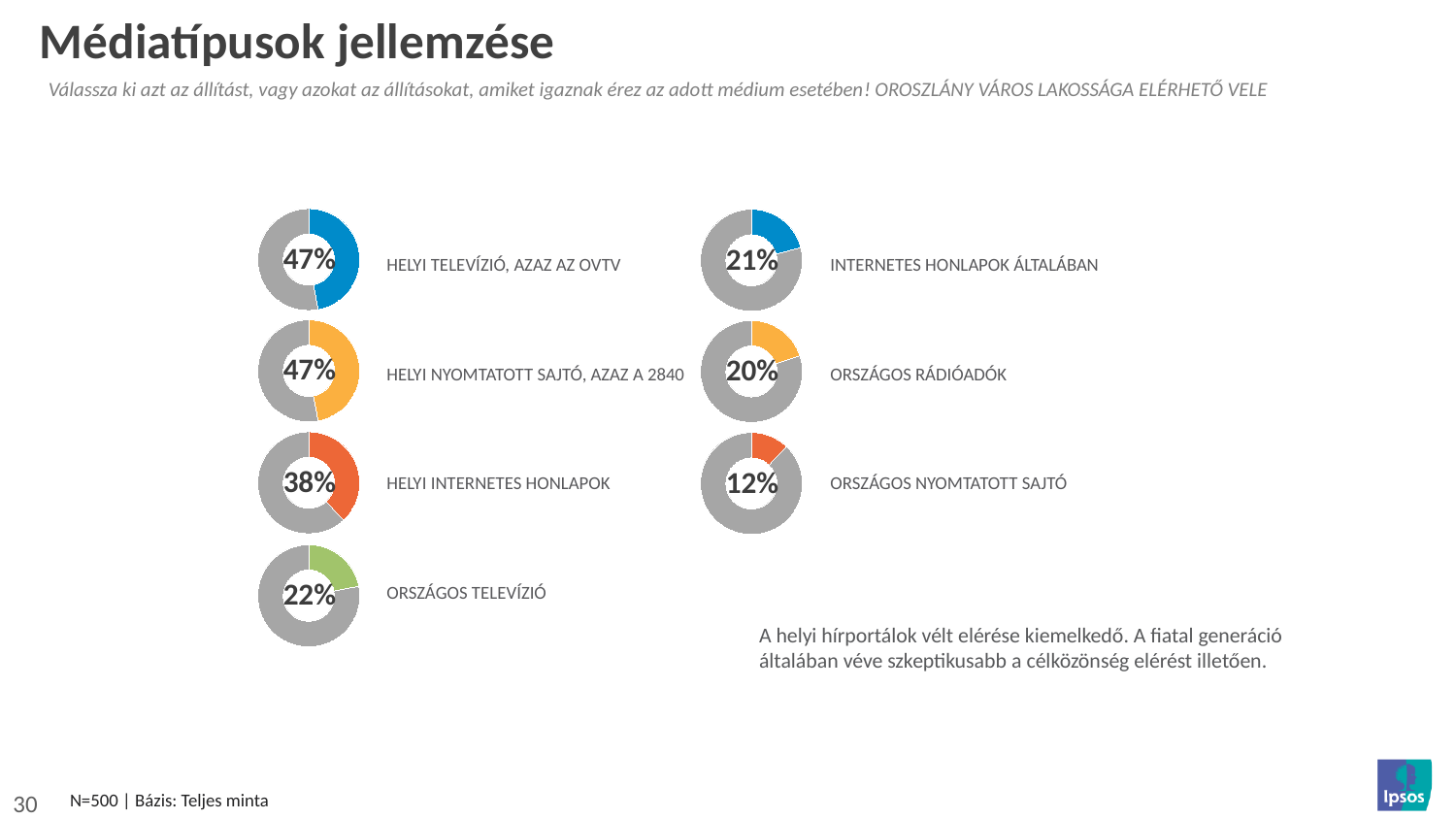
What is the difference between the percentage for HELYI INTERNETES HONLAPOK and the percentage for ORSZÁGOS NYOMTATOTT SAJTÓ? 26% What kind of chart is used to show the percentage for each medium on the slide? Donut chart What percentage is shown in the donut chart for ORSZÁGOS NYOMTATOTT SAJTÓ? 12% How many donut charts are shown on the slide? 7 What percentage is shown in the donut chart for ORSZÁGOS TELEVÍZIÓ? 22% What percentage is shown in the donut chart for ORSZÁGOS RÁDIÓADÓK? 20% Which is larger: the percentage for HELYI INTERNETES HONLAPOK or the percentage for ORSZÁGOS TELEVÍZIÓ? HELYI INTERNETES HONLAPOK Which medium has the lowest percentage among the donut charts on the slide? ORSZÁGOS NYOMTATOTT SAJTÓ What percentage is shown in the donut chart for INTERNETES HONLAPOK ÁLTALÁBAN? 21% What percentage is shown in the donut chart for HELYI INTERNETES HONLAPOK? 38% What percentage is shown in the donut chart for HELYI TELEVÍZIÓ, AZAZ AZ OVTV? 47% What is the difference between the percentage for HELYI NYOMTATOTT SAJTÓ, AZAZ A 2840 and the percentage for ORSZÁGOS RÁDIÓADÓK? 27%